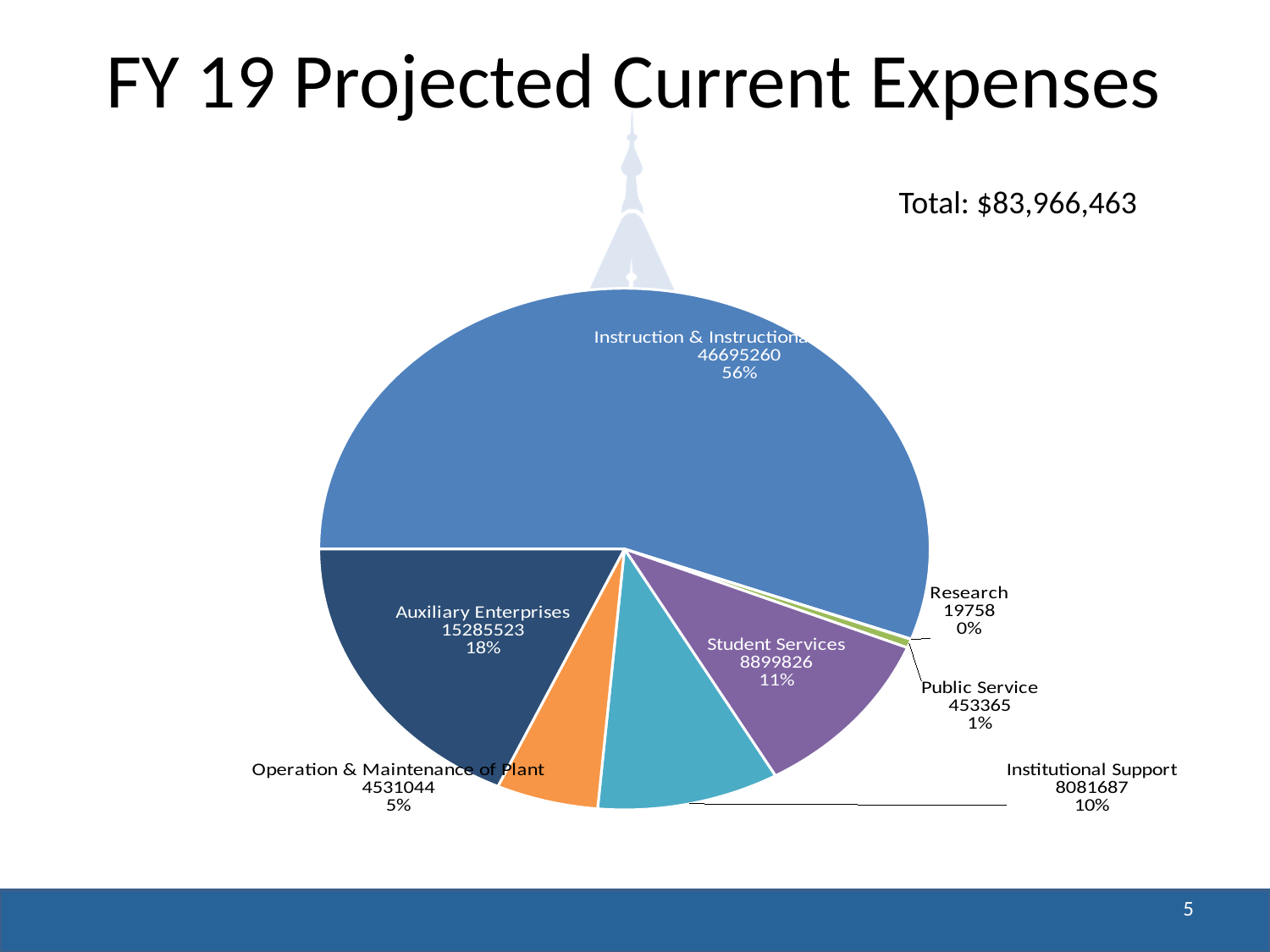
Which category has the smallest slice of the pie? Research What percentage of the pie does Student Services represent? 11% What is the difference between the Auxiliary Enterprises value and the Operation & Maintenance of Plant value? 10754479 What share of the pie is Auxiliary Enterprises? 18% How many slices does the pie chart have? 7 What is the value shown for Auxiliary Enterprises? 15285523 What is the value shown for Institutional Support? 8081687 Which is larger, Student Services or Institutional Support? Student Services What total amount is stated on the slide? $83,966,463 What is the value shown for Public Service? 453365 Which category has the largest slice of the pie? Instruction & Instructional Support What type of chart is shown on the slide? Pie chart